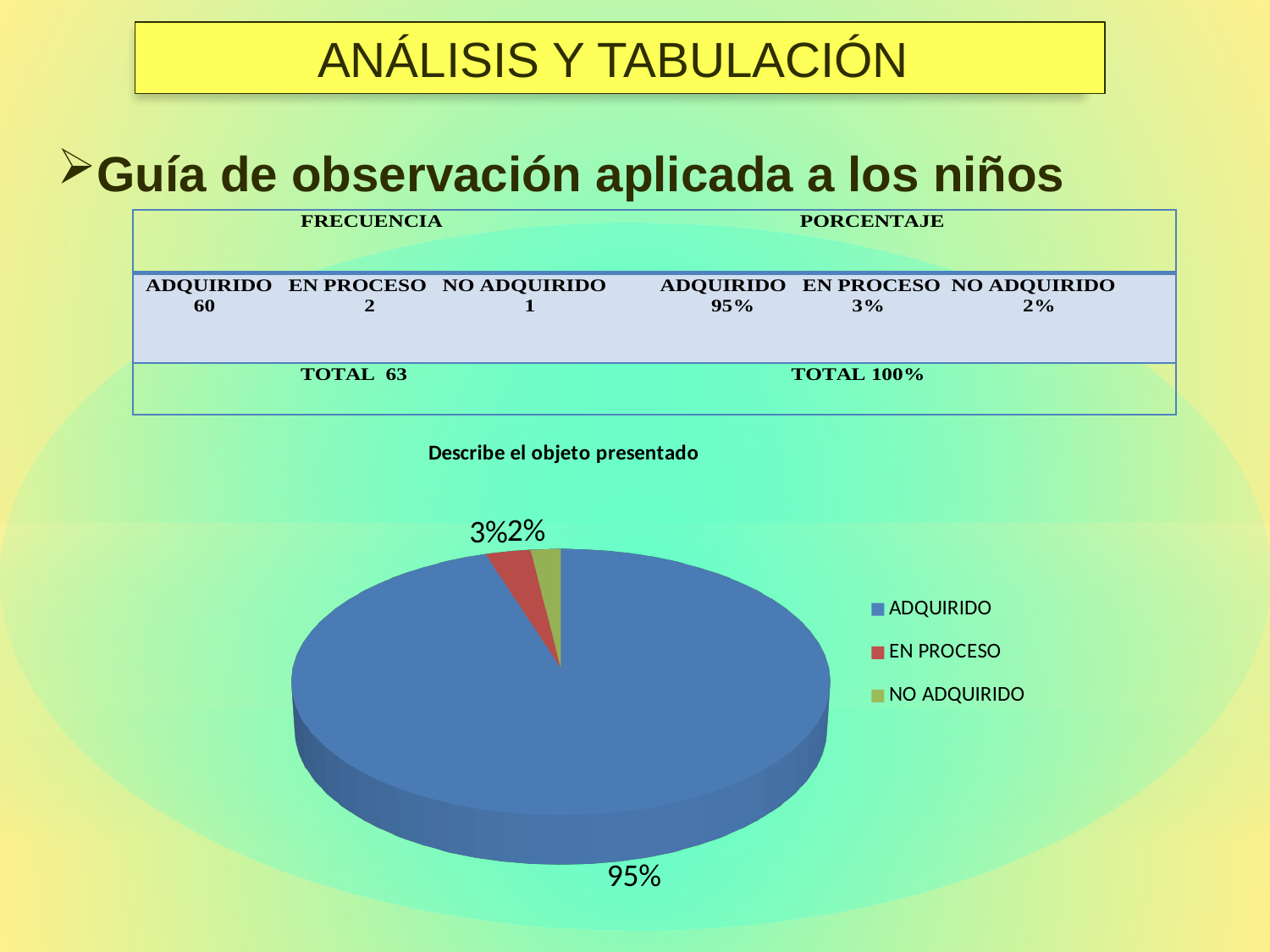
What percentage does the EN PROCESO slice show? 3% What is the title of the pie chart? Describe el objeto presentado Which category has the largest slice in the pie chart? ADQUIRIDO Which slice is larger, EN PROCESO or NO ADQUIRIDO? EN PROCESO What kind of chart is shown on the slide? pie chart What percentage does the NO ADQUIRIDO slice show? 2% What percentage does the ADQUIRIDO slice show? 95% Which category has the smallest slice in the pie chart? NO ADQUIRIDO How many entries does the legend of the pie chart list? 3 What is the difference in percentage points between the ADQUIRIDO slice and the EN PROCESO slice? 92 Which legend entry is shown in blue? ADQUIRIDO How many slices does the pie chart have? 3